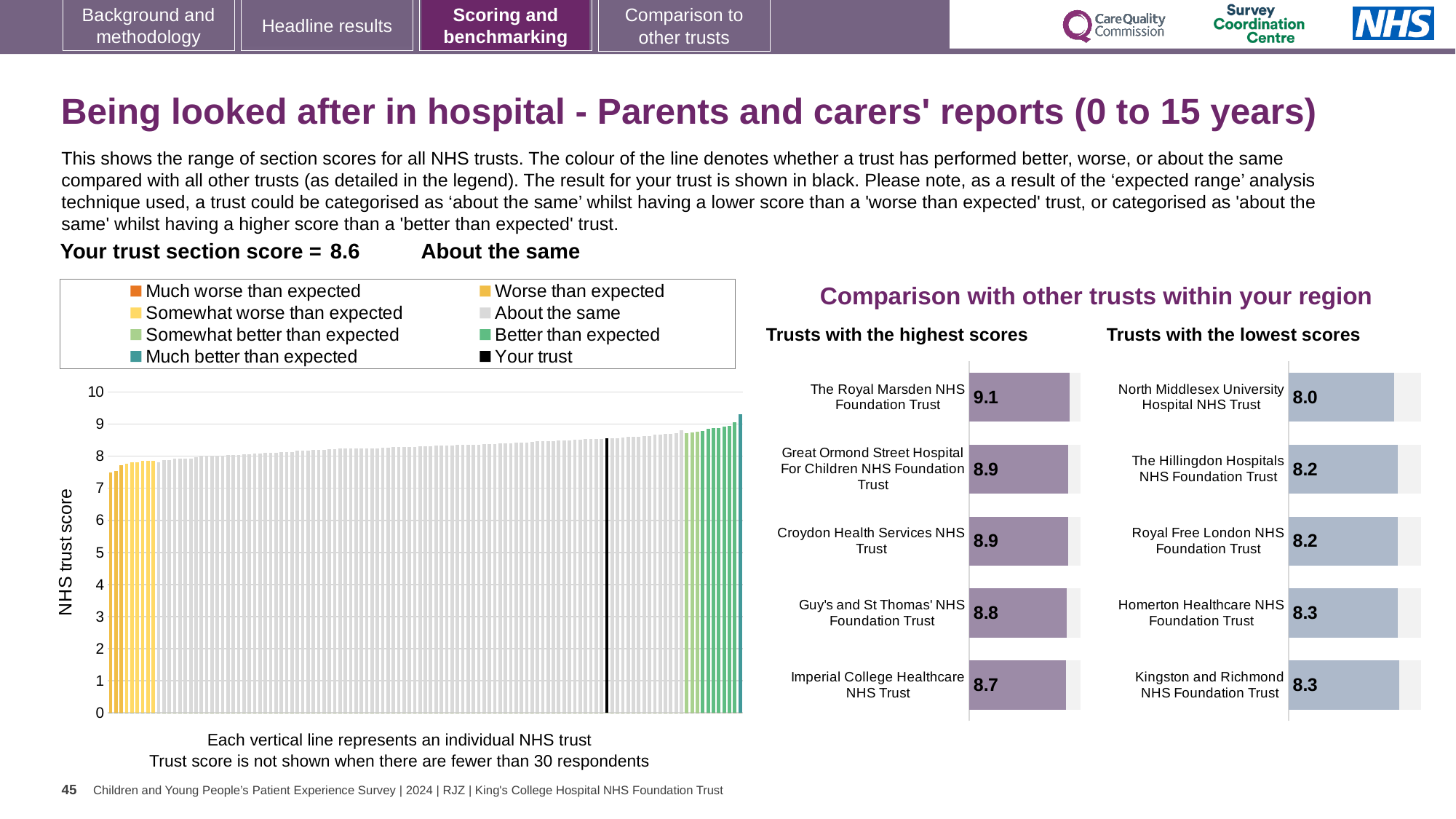
In the 'Trusts with the highest scores' chart, what is the score for The Royal Marsden NHS Foundation Trust? 9.1 In the 'Trusts with the lowest scores' chart, how much higher is the score of Kingston and Richmond NHS Foundation Trust than that of North Middlesex University Hospital NHS Trust? 0.3 In the 'Trusts with the lowest scores' chart, what is the score for Homerton Healthcare NHS Foundation Trust? 8.3 How many trusts are shown in the 'Trusts with the highest scores' chart? 5 In the 'Trusts with the lowest scores' chart, which trust has the lowest score? North Middlesex University Hospital NHS Trust In the 'Trusts with the highest scores' chart, which has the higher score: Croydon Health Services NHS Trust or Guy's and St Thomas' NHS Foundation Trust? Croydon Health Services NHS Trust How many entries does the legend of the NHS trust score chart on the left list? 8 In the NHS trust score chart on the left, is the value for the black 'Your trust' line greater or less than 8? greater In the 'Trusts with the highest scores' chart, what is the score for Imperial College Healthcare NHS Trust? 8.7 In the 'Trusts with the highest scores' chart, what is the difference between the scores of The Royal Marsden NHS Foundation Trust and Imperial College Healthcare NHS Trust? 0.4 In the 'Trusts with the lowest scores' chart, what is the score for North Middlesex University Hospital NHS Trust? 8.0 In the 'Trusts with the highest scores' chart, which trust has the highest score? The Royal Marsden NHS Foundation Trust